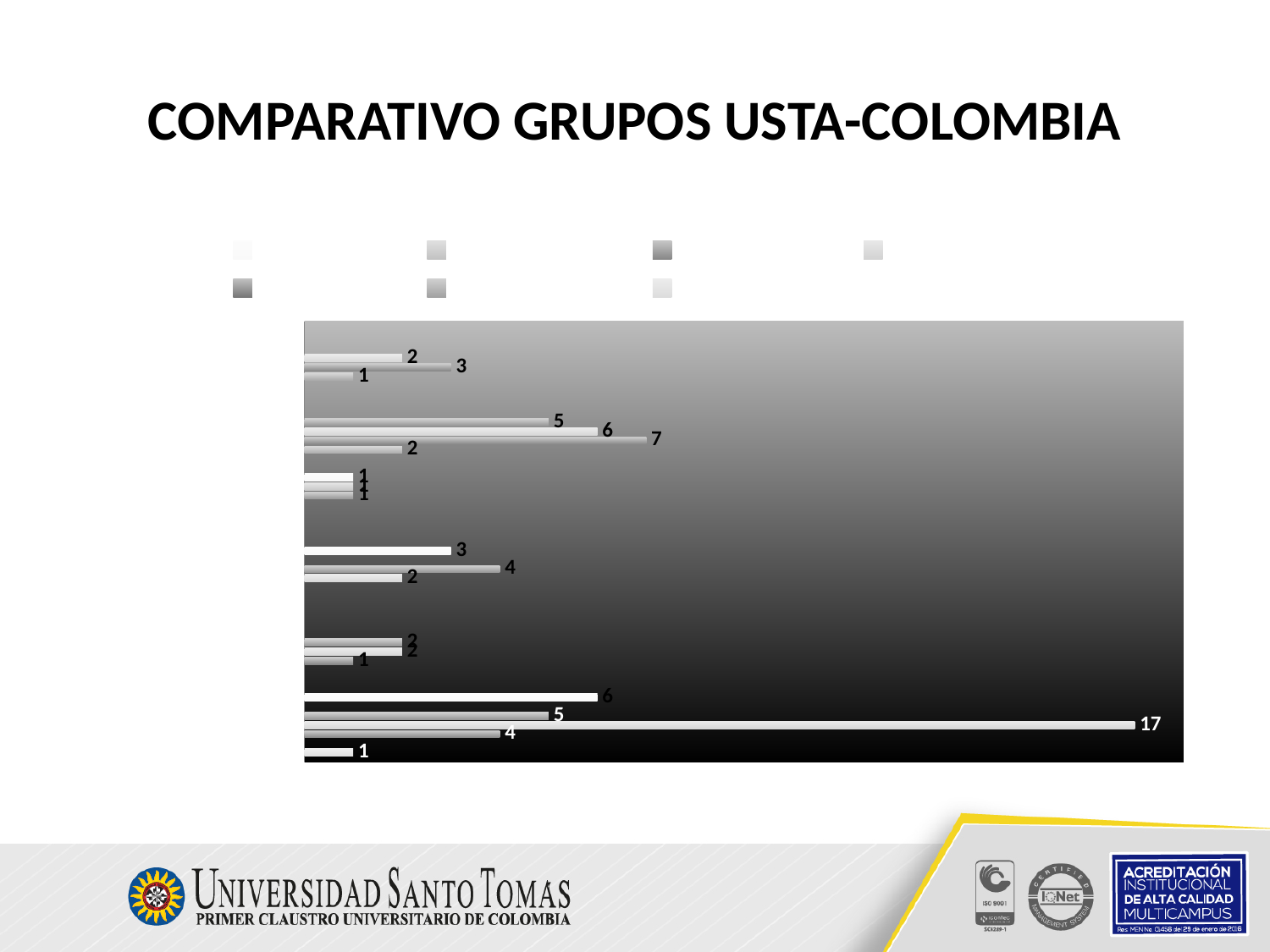
What is the lowest value labelled on any bar in the chart? 1 What is the highest value labelled on any bar in the chart? 17 How many series does the chart's legend list? 7 What is the title shown above the chart on the slide? COMPARATIVO GRUPOS USTA-COLOMBIA What kind of chart is shown on the slide? bar chart Which is larger: the bar labelled 17 or the bar labelled 7? the bar labelled 17 What is the difference between the largest labelled value (17) and the second largest labelled value (7)? 10 Are the bars in the chart oriented horizontally or vertically? horizontally How many groups of bars are plotted in the chart? 6 Is the longest bar in the chart labelled with a value greater or less than 10? greater